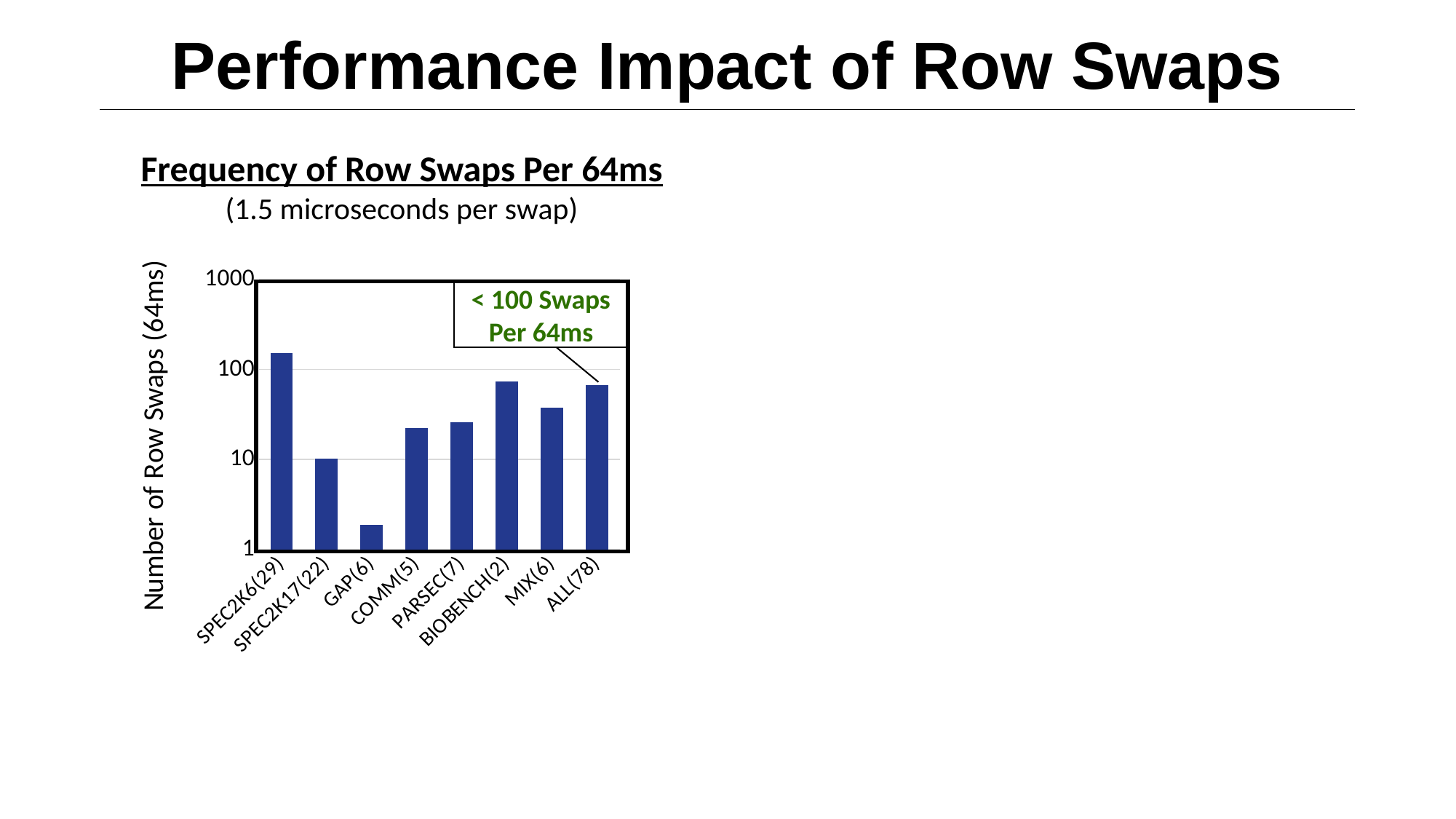
Which category has the lowest number of row swaps? GAP(6) Which category has the highest number of row swaps? SPEC2K6(29) Is the value for ALL(78) greater or less than 100? less Which has a higher number of row swaps, MIX(6) or GAP(6)? MIX(6) Is the value for BIOBENCH(2) greater or less than 10? greater Is the value for GAP(6) greater or less than 10? less What does the green annotation on the chart say? < 100 Swaps Per 64ms Which has a higher number of row swaps, BIOBENCH(2) or COMM(5)? BIOBENCH(2) What is the label of the y-axis of the chart? Number of Row Swaps (64ms) What kind of chart is shown on the slide? bar chart How many categories (bars) are plotted in the chart? 8